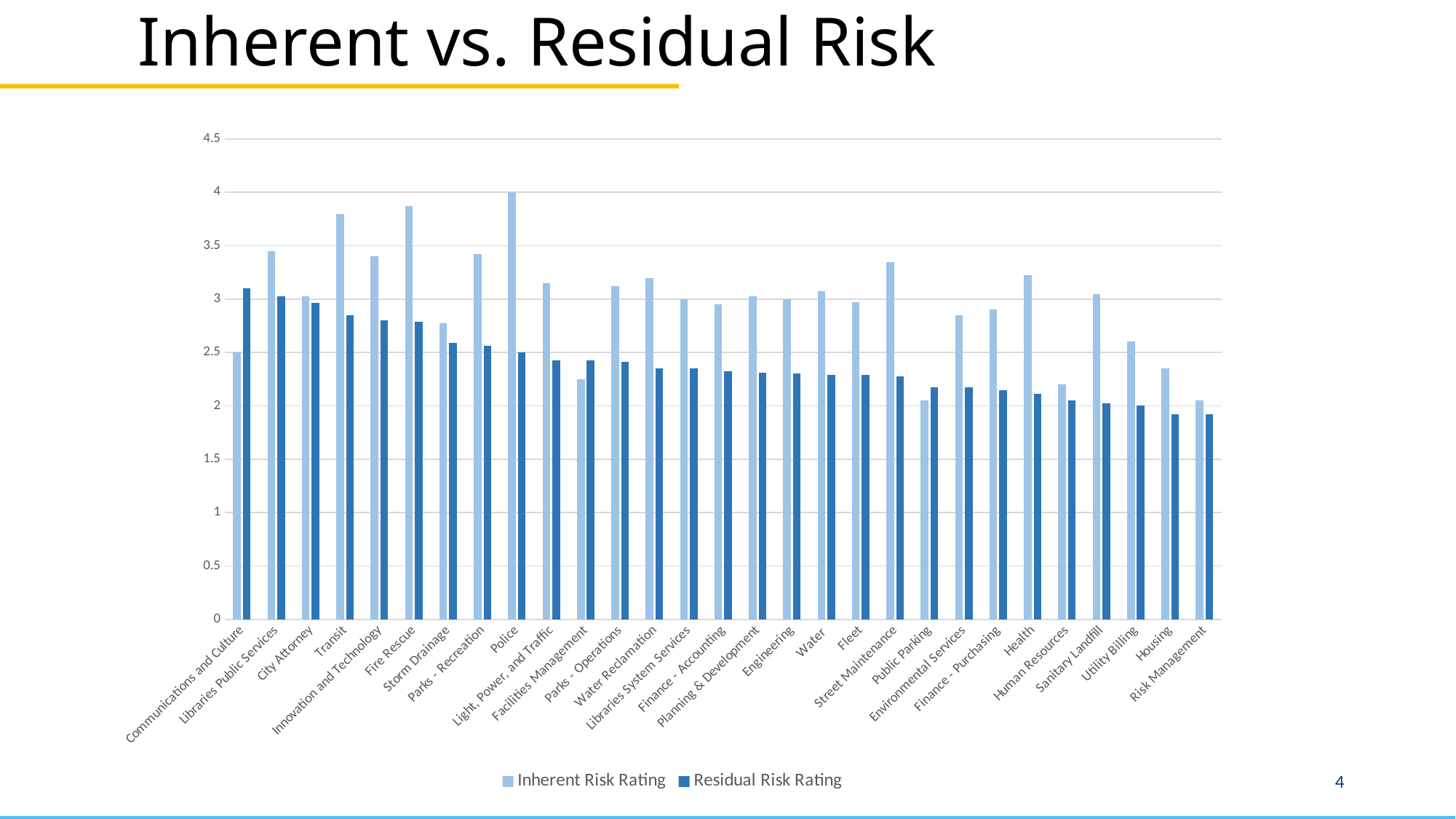
How many series does the legend list? 2 What are the two series named in the legend? Inherent Risk Rating and Residual Risk Rating Is the Residual Risk Rating for Police greater or less than 3? less Which department has the highest Inherent Risk Rating? Police What kind of chart is shown on the slide? bar chart For Communications and Culture, which is larger: the Inherent Risk Rating or the Residual Risk Rating? Residual Risk Rating Is the Inherent Risk Rating for Storm Drainage greater or less than 3? less Is the Inherent Risk Rating for Street Maintenance greater or less than 3? greater Which has the larger Inherent Risk Rating: Police or Transit? Police How many departments (categories) are shown on the x axis? 29